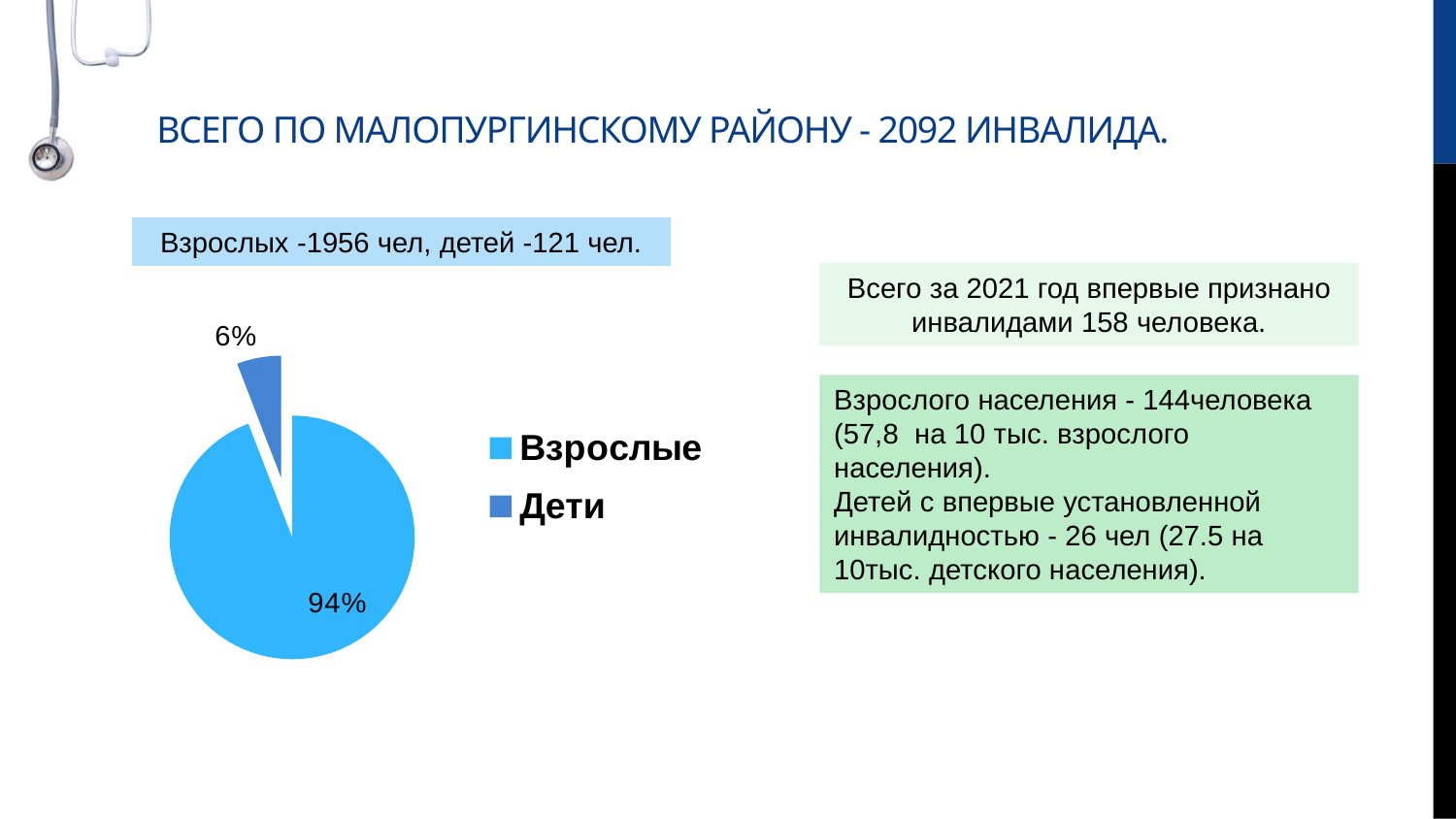
What is the difference in percentage points between the Взрослые slice and the Дети slice? 88 How many slices does the pie chart have? 2 Which legend entry is shown in the darker blue colour? Дети How many entries does the legend of the pie chart list? 2 Which slice of the pie chart is the smallest? Дети What share of the pie does the Дети slice represent? 6% What share of the pie does the Взрослые slice represent? 94% Which is larger in the pie chart, the Взрослые slice or the Дети slice? Взрослые Which legend entry is listed first in the pie chart's legend? Взрослые What kind of chart is shown on the slide? pie chart Which slice of the pie chart is the largest? Взрослые